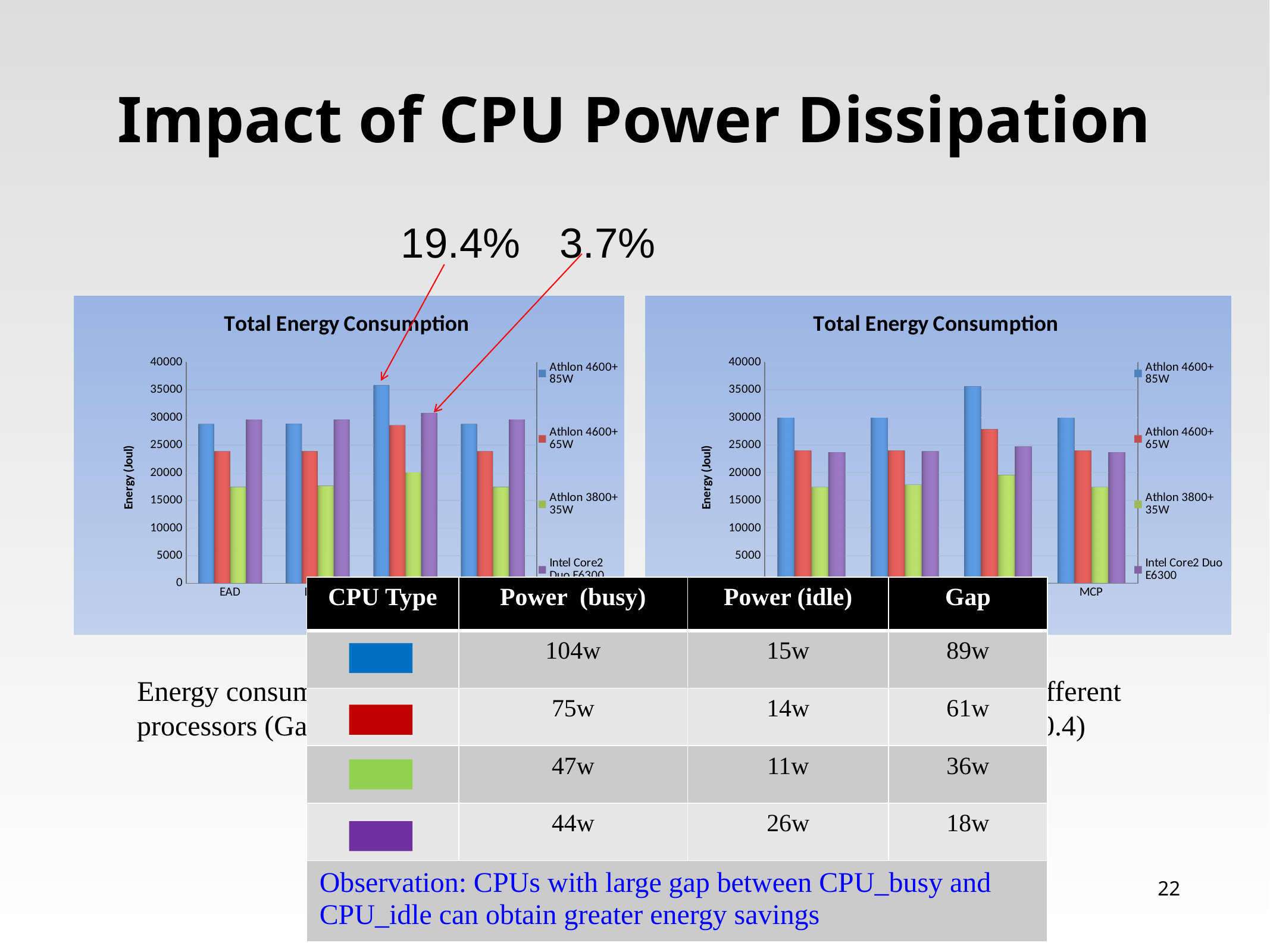
How many series does the legend of the right 'Total Energy Consumption' chart list? 4 In the left 'Total Energy Consumption' chart, how many groups of bars are plotted along the x axis? 4 In the left 'Total Energy Consumption' chart, is the value for Athlon 4600+ 85W at EAD greater or less than 25000? greater In the right 'Total Energy Consumption' chart, which series has the lowest value at MCP? Athlon 3800+ 35W What is the y-axis title of the right 'Total Energy Consumption' chart? Energy (Joul) In the left 'Total Energy Consumption' chart, at EAD, which is larger: Athlon 4600+ 65W or Athlon 3800+ 35W? Athlon 4600+ 65W In the left 'Total Energy Consumption' chart, which series has the lowest value at EAD? Athlon 3800+ 35W In the right 'Total Energy Consumption' chart, is the value for Athlon 3800+ 35W at MCP greater or less than 20000? less In the left 'Total Energy Consumption' chart, is the value for Athlon 3800+ 35W at EAD greater or less than 20000? less In the right 'Total Energy Consumption' chart, which series has the highest value at MCP? Athlon 4600+ 85W What kind of chart is the left 'Total Energy Consumption' chart? bar chart